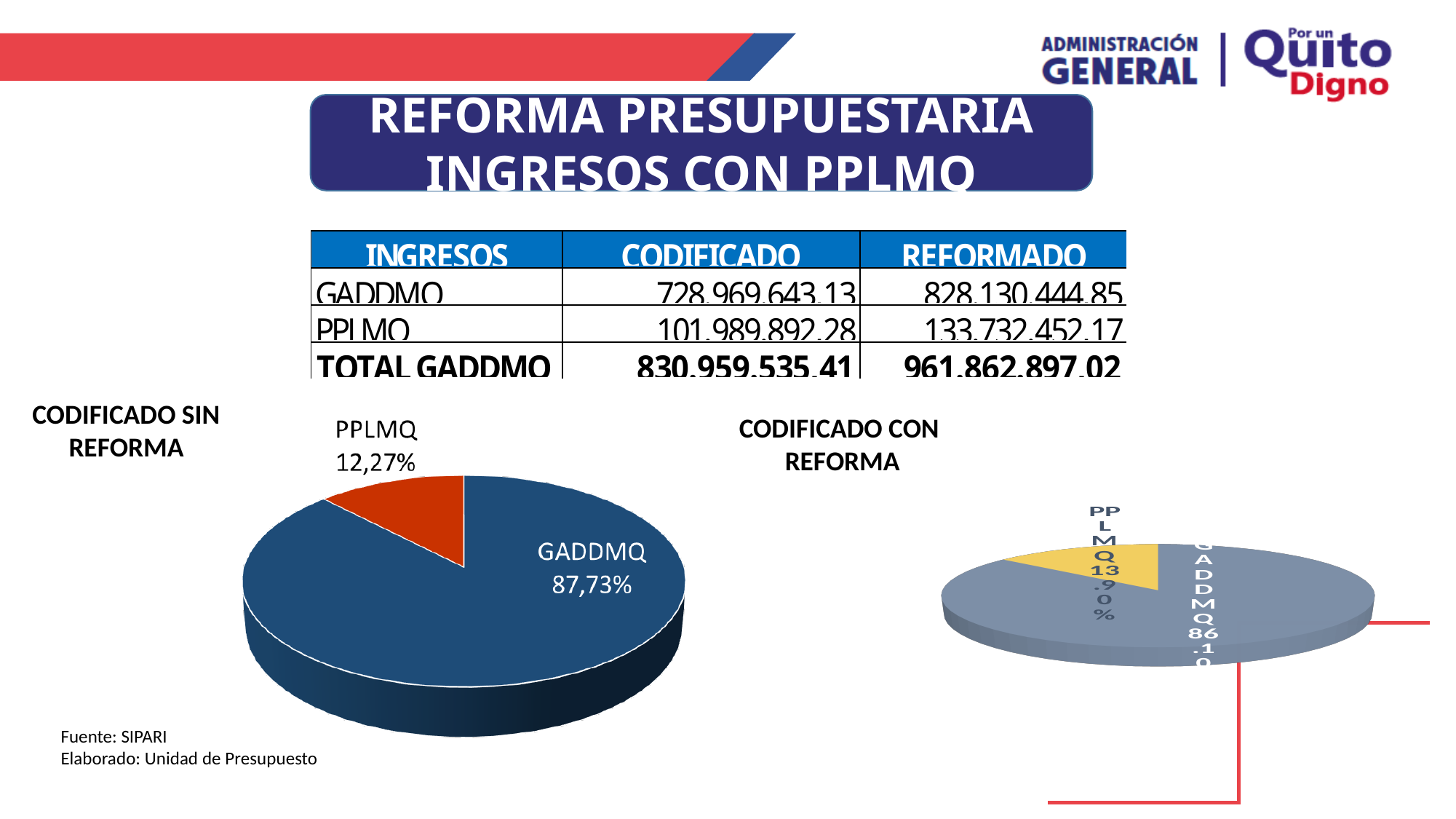
In the CODIFICADO SIN REFORMA pie chart, by how many percentage points does GADDMQ exceed PPLMQ? 75,46 percentage points In the CODIFICADO CON REFORMA pie chart, which slice is the largest? GADDMQ In the CODIFICADO SIN REFORMA pie chart, what share does PPLMQ have? 12,27% What kind of chart is the CODIFICADO SIN REFORMA chart? Pie chart In the CODIFICADO SIN REFORMA pie chart, which is larger, GADDMQ or PPLMQ? GADDMQ In the CODIFICADO CON REFORMA pie chart, what share does PPLMQ have? 13.90% In the CODIFICADO SIN REFORMA pie chart, what share does GADDMQ have? 87,73% In the CODIFICADO SIN REFORMA pie chart, what colour is the PPLMQ slice? Red In the CODIFICADO SIN REFORMA pie chart, which slice is the smallest? PPLMQ How many slices does the CODIFICADO SIN REFORMA pie chart have? 2 How many slices does the CODIFICADO CON REFORMA pie chart have? 2 In the CODIFICADO SIN REFORMA pie chart, which slice is the largest? GADDMQ